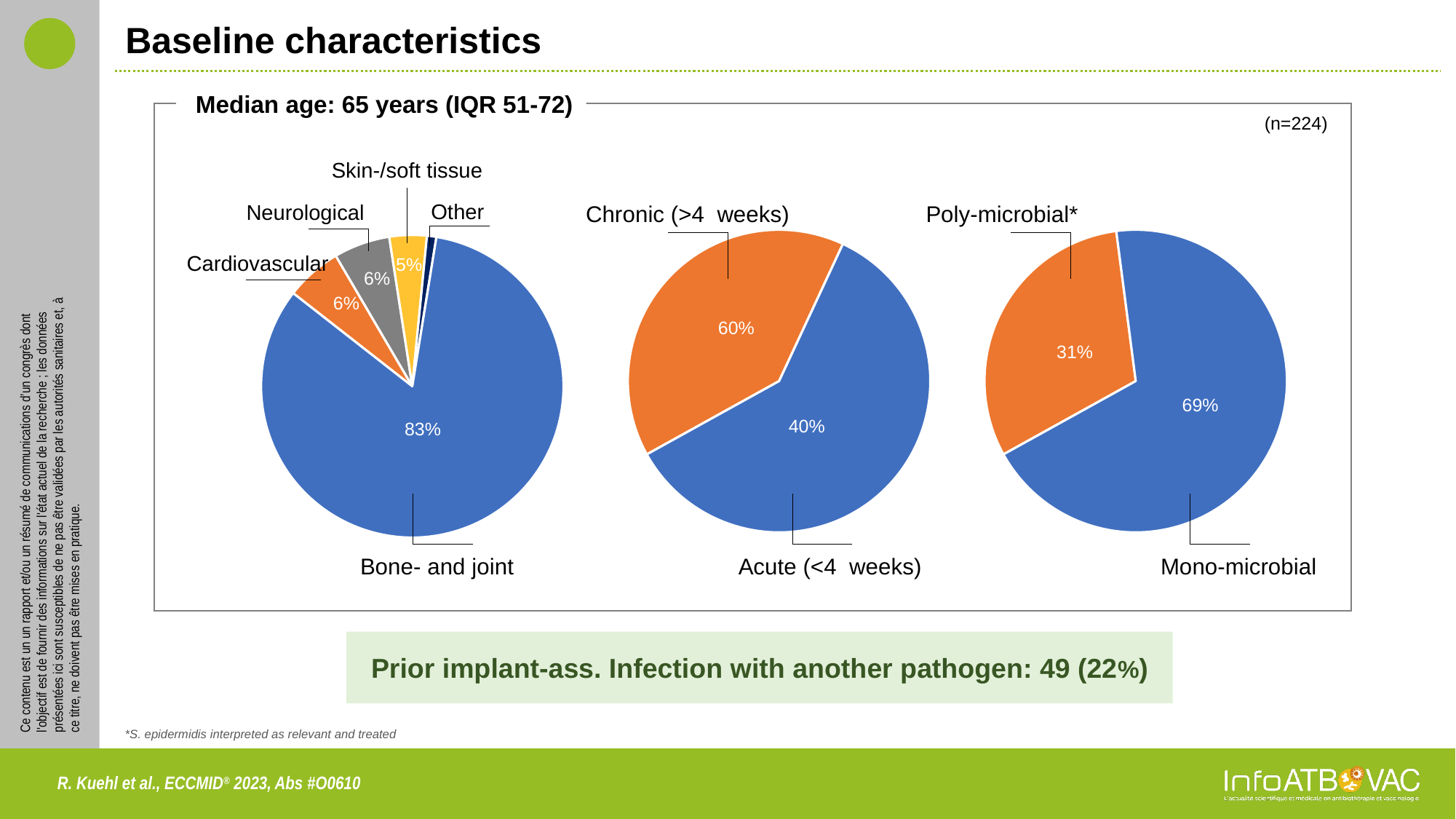
In the middle pie chart, what share is labelled for Chronic (>4 weeks)? 60% In the left pie chart, what share is labelled for Bone- and joint? 83% In the left pie chart, what share is labelled for Skin-/soft tissue? 5% In the right pie chart, what share is labelled for Poly-microbial*? 31% What type of chart is used for the three charts on the slide? Pie chart In the middle pie chart, what share is labelled for Acute (<4 weeks)? 40% In the right pie chart, which is larger, Mono-microbial or Poly-microbial*? Mono-microbial What sample size (n) is shown above the charts? n=224 How many slices does the left pie chart have? 5 In the left pie chart, which category has the largest slice? Bone- and joint In the middle pie chart, what is the difference in percentage points between Chronic (>4 weeks) and Acute (<4 weeks)? 20 percentage points In the left pie chart, which category has the smallest slice? Other